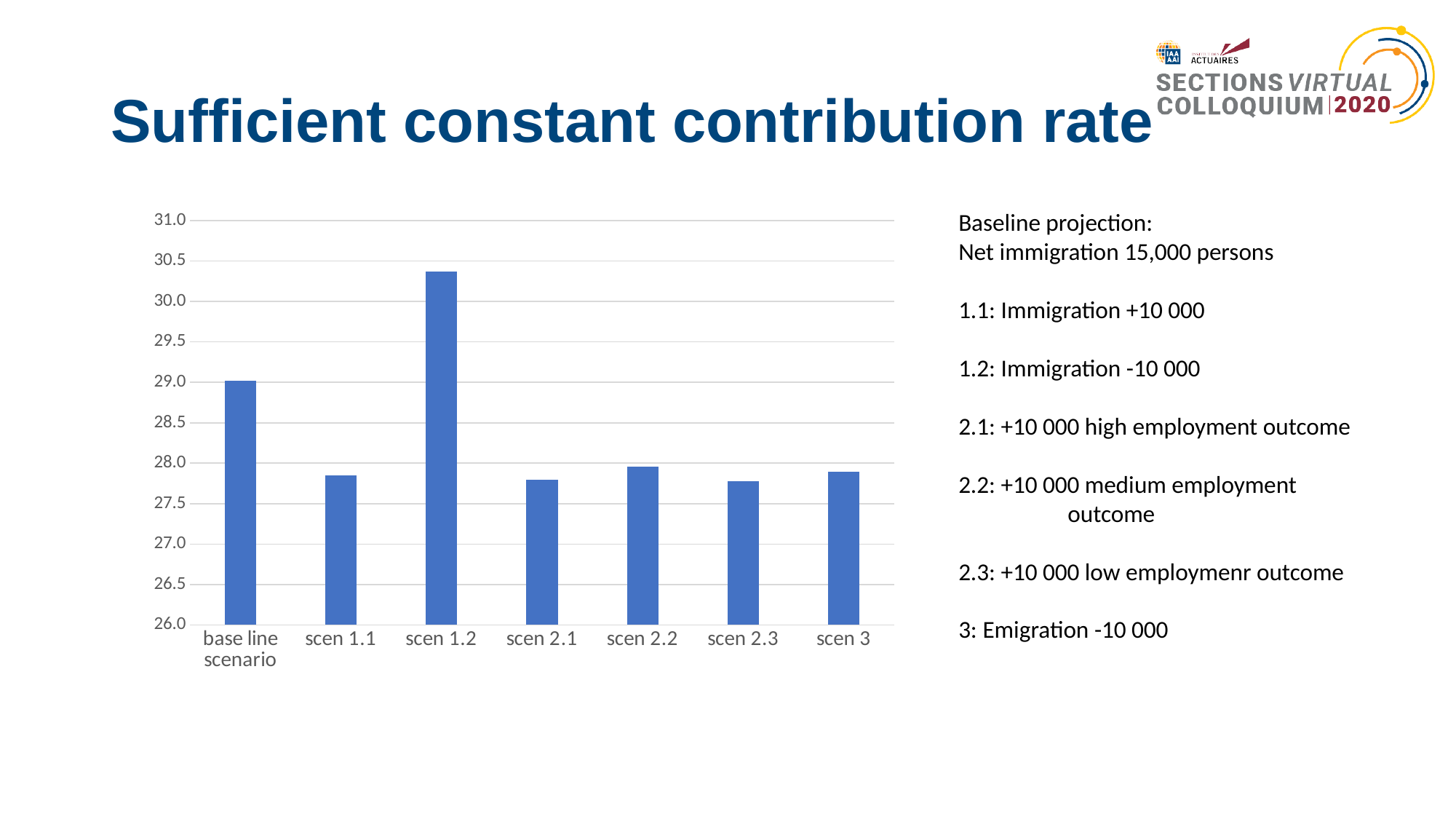
Is the value for the base line scenario greater or less than 28.5? greater Which scenario has the highest sufficient constant contribution rate? scen 1.2 What is the title of the slide containing the chart? Sufficient constant contribution rate Is the value for scen 3 greater or less than 28.5? less How many scenarios (bars) are plotted in the chart? 7 Is the value for scen 2.1 greater or less than 28.0? less What kind of chart is shown on the slide? bar chart What is the lowest value shown on the vertical axis of the chart? 26.0 Which is larger, the value for scen 1.2 or the value for scen 2.2? scen 1.2 Which is larger, the value for the base line scenario or the value for scen 1.1? base line scenario